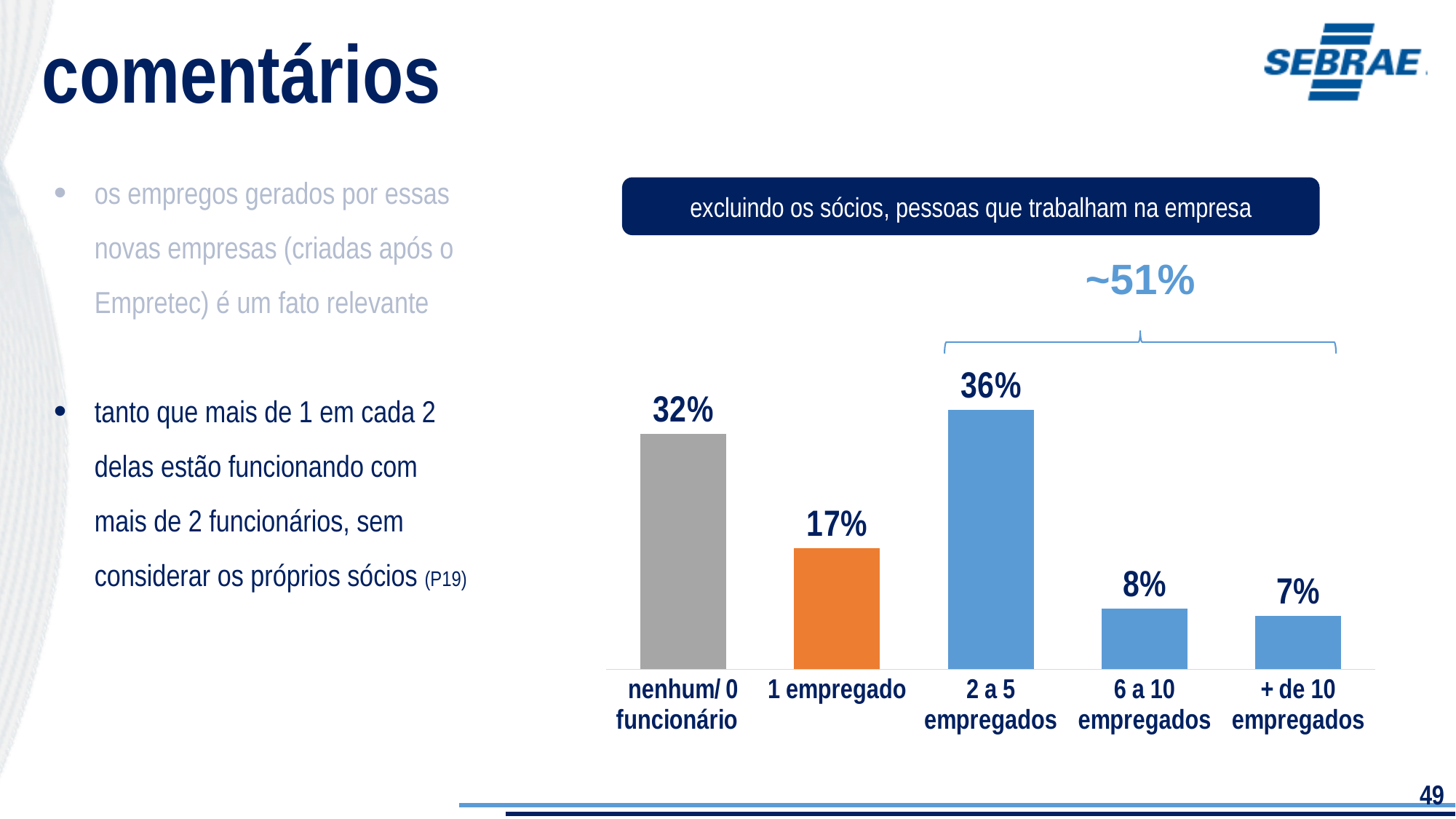
What kind of chart is shown on the slide? bar chart What is the text in the dark box above the chart? excluindo os sócios, pessoas que trabalham na empresa How many categories are shown on the chart? 5 What is the value for '+ de 10 empregados'? 7% What is the difference between the values for '2 a 5 empregados' and 'nenhum/ 0 funcionário'? 4% What is the value for '1 empregado'? 17% Which is larger, the value for '1 empregado' or the value for '6 a 10 empregados'? 1 empregado What is the value for 'nenhum/ 0 funcionário'? 32% Which category has the highest value? 2 a 5 empregados What is the difference between the values for '1 empregado' and '6 a 10 empregados'? 9% Which category has the lowest value? + de 10 empregados What is the value for '2 a 5 empregados'? 36%